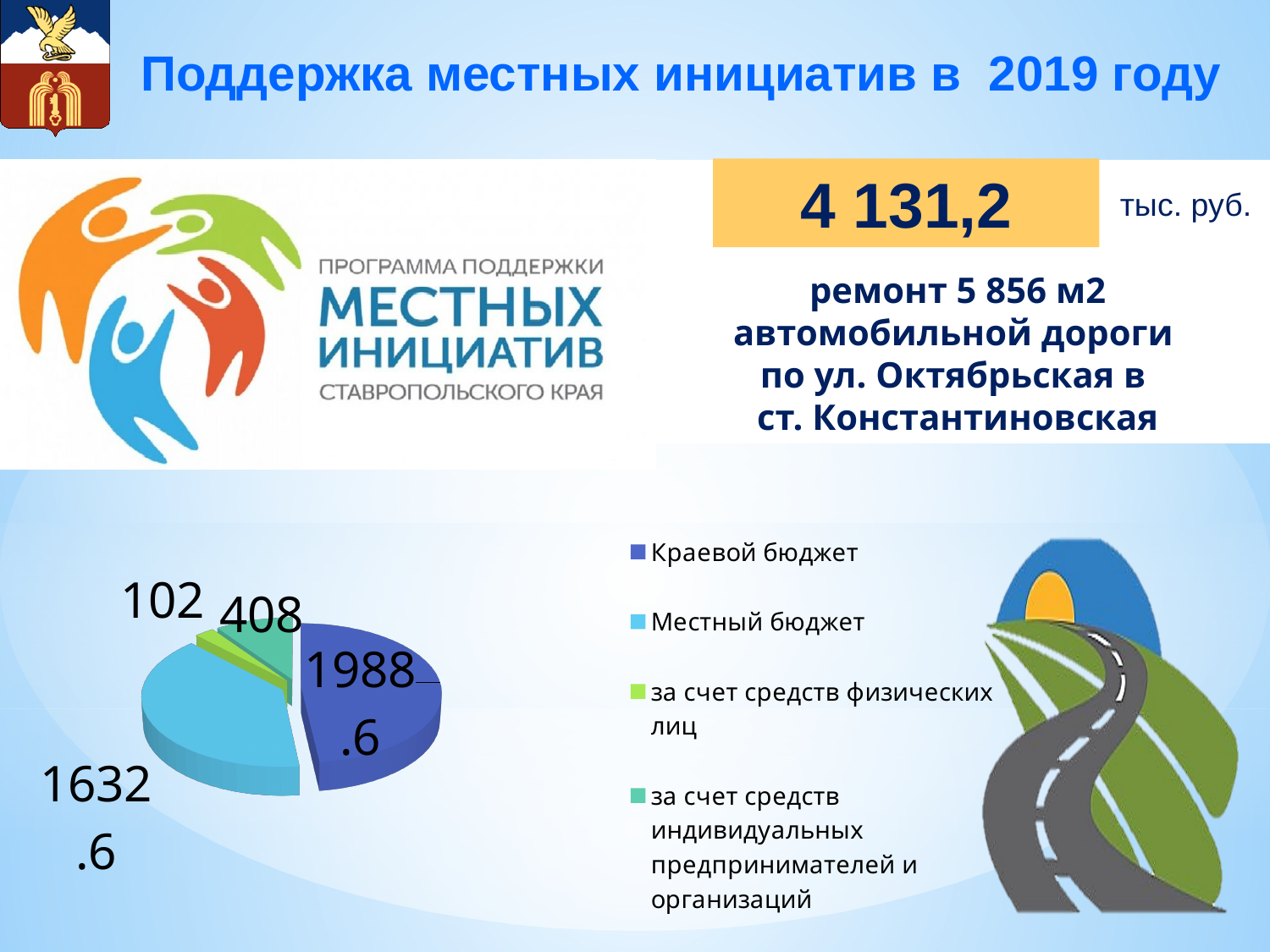
How many slices does the pie chart have? 4 Which category has the largest slice in the pie chart? Краевой бюджет Which is larger in the pie chart: за счет средств физических лиц or за счет средств индивидуальных предпринимателей и организаций? за счет средств индивидуальных предпринимателей и организаций What is the value for за счет средств физических лиц in the pie chart? 102 What is the value for Местный бюджет in the pie chart? 1632.6 How many entries does the legend of the pie chart list? 4 What type of chart is shown on the slide? pie chart Which category has the smallest slice in the pie chart? за счет средств физических лиц What is the value for Краевой бюджет in the pie chart? 1988.6 What is the total of all slices in the pie chart? 4131.2 What is the value for за счет средств индивидуальных предпринимателей и организаций in the pie chart? 408 What is the difference between Краевой бюджет and Местный бюджет in the pie chart? 356